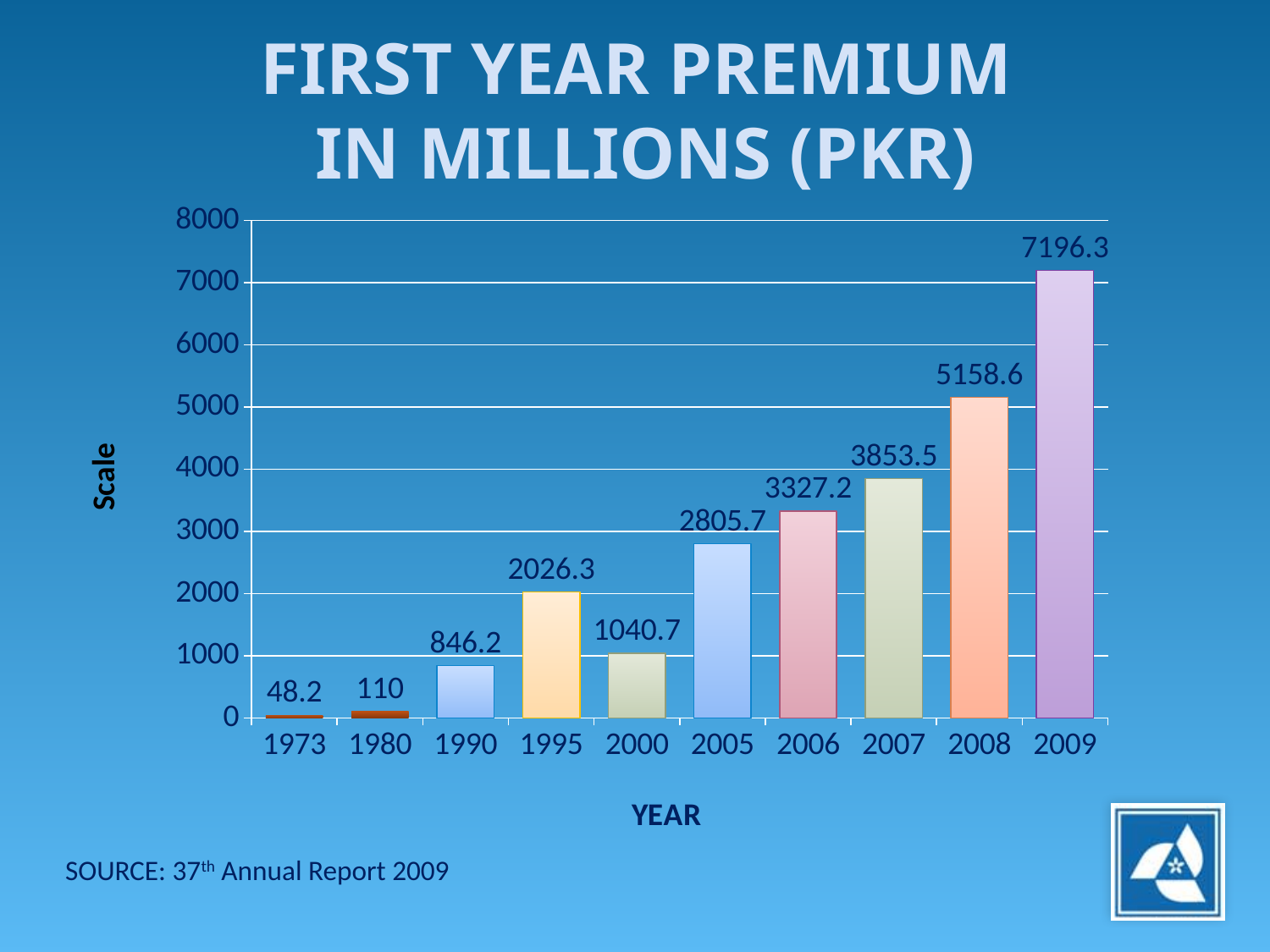
What is the difference between the values for 2009 and 2008? 2037.7 What is the first year premium value for 2005? 2805.7 Is the value for 2007 greater or less than 4000? less Which year has the highest first year premium? 2009 How many years are shown on the x axis? 10 What kind of chart is shown on the slide? bar chart What is the label of the y axis? Scale What is the difference between the values for 1995 and 2000? 985.6 What is the first year premium value for 1990? 846.2 Which is larger, the value for 1995 or the value for 2000? 1995 What is the first year premium value for 2009? 7196.3 Which year has the lowest first year premium? 1973